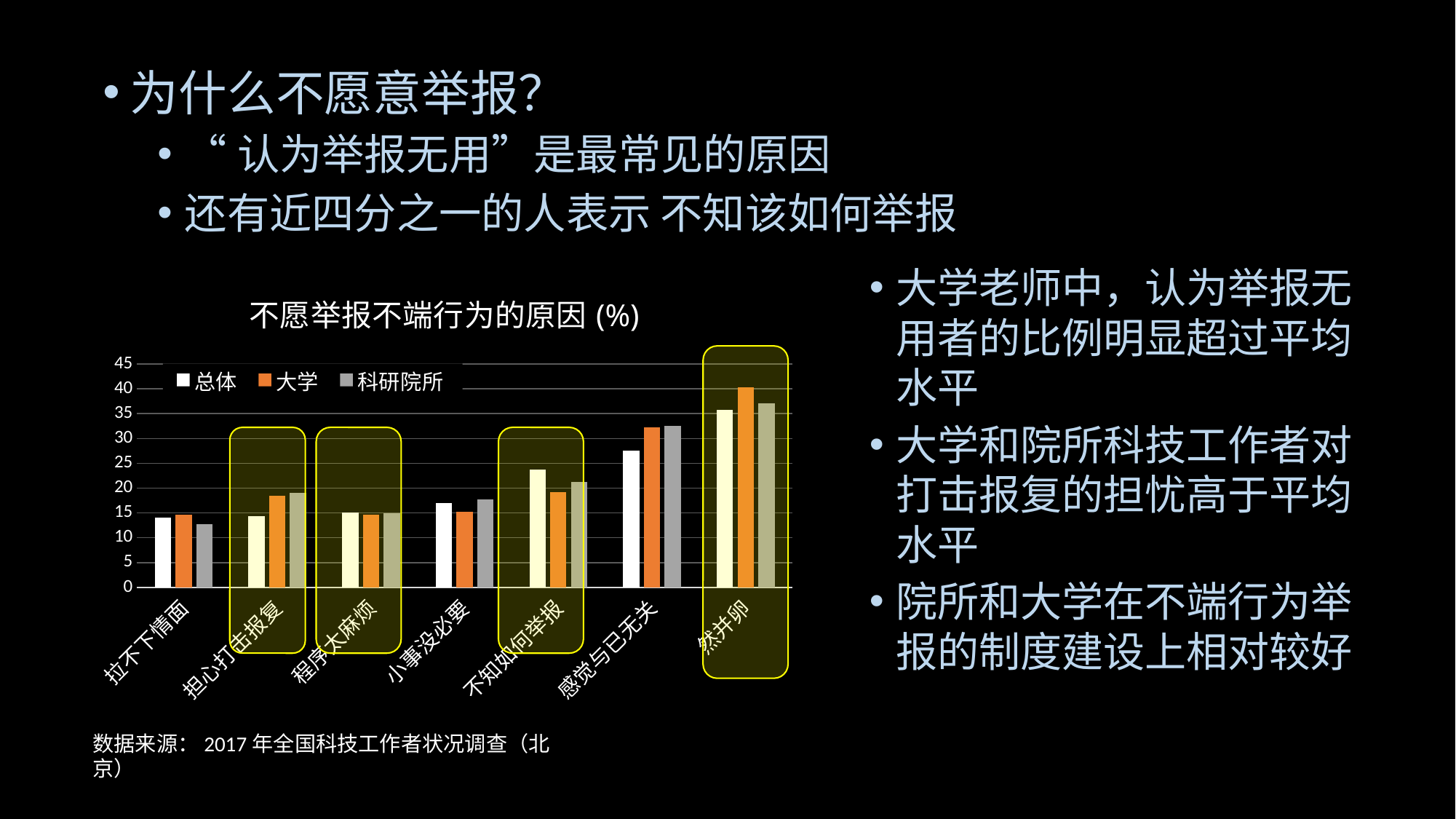
How many series does the chart legend list? 3 Which category has the highest value for the 总体 series? 然并卵 What is the title of the chart? 不愿举报不端行为的原因 (%) In the 不知如何举报 category, which is larger: the value for 总体 or for 大学? 总体 How many categories are shown on the x axis of the chart? 7 Is the value for 总体 in the 感觉与已无关 category greater or less than 25? greater Which category has the highest value for the 大学 series? 然并卵 Which series is shown in orange in the chart legend? 大学 What kind of chart is shown on the slide? bar chart Is the value for 大学 in the 然并卵 category greater or less than 35? greater Is the value for 科研院所 in the 拉不下情面 category greater or less than 15? less In the 担心打击报复 category, which is larger: the value for 总体 or for 大学? 大学